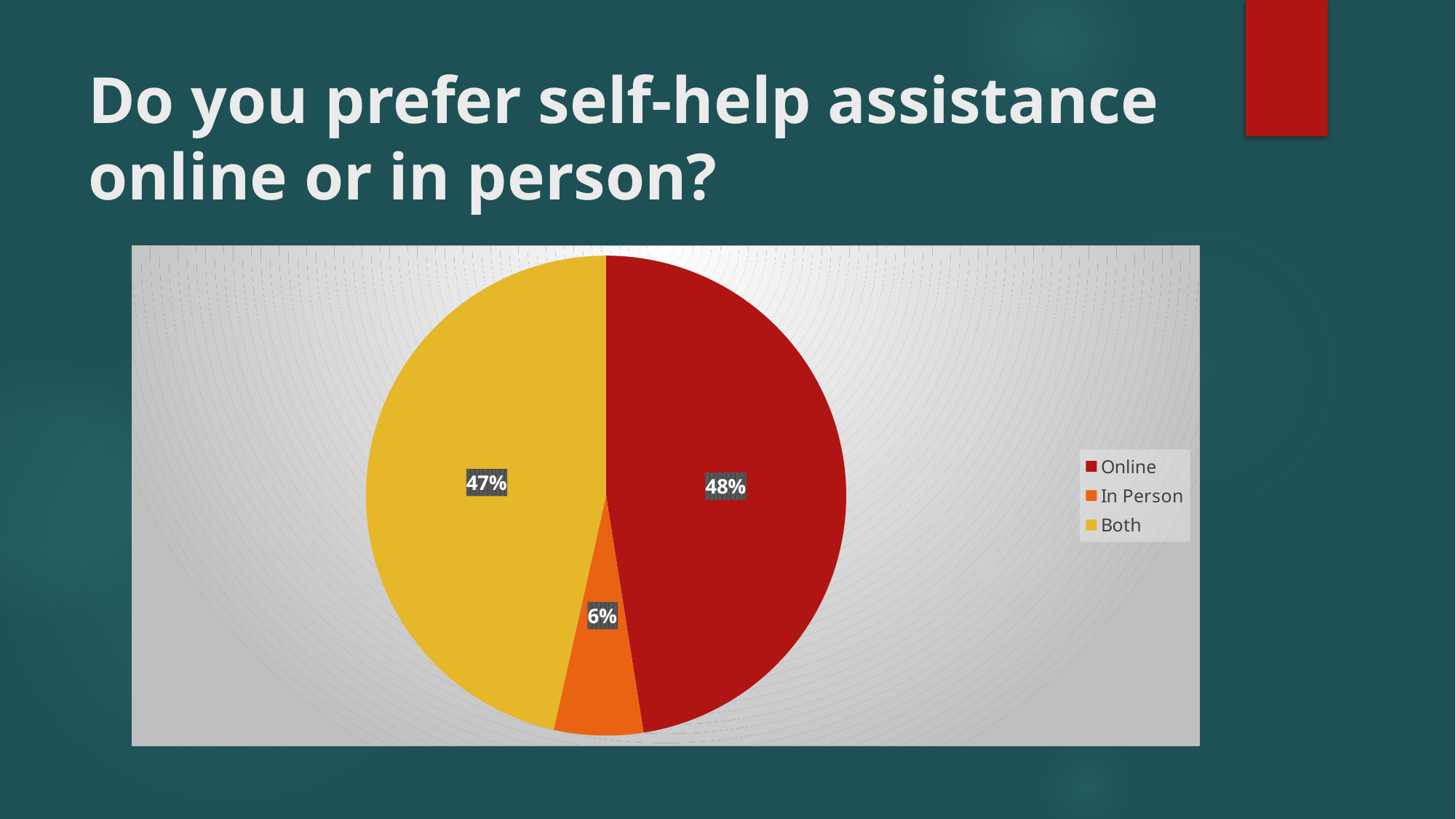
What kind of chart is shown on the slide? Pie chart Which category has the largest slice of the pie? Online Which is larger, the Both slice or the In Person slice? Both What share of the pie does the Online slice represent? 48% What question does the slide title ask? Do you prefer self-help assistance online or in person? What percentage is shown for In Person? 6% What is the difference in percentage points between Both and In Person? 41 Which category has the smallest slice of the pie? In Person What is the difference in percentage points between Online and In Person? 42 What colour is the Both slice in the pie chart? Yellow How many slices does the pie chart have? 3 What percentage is shown for Both? 47%